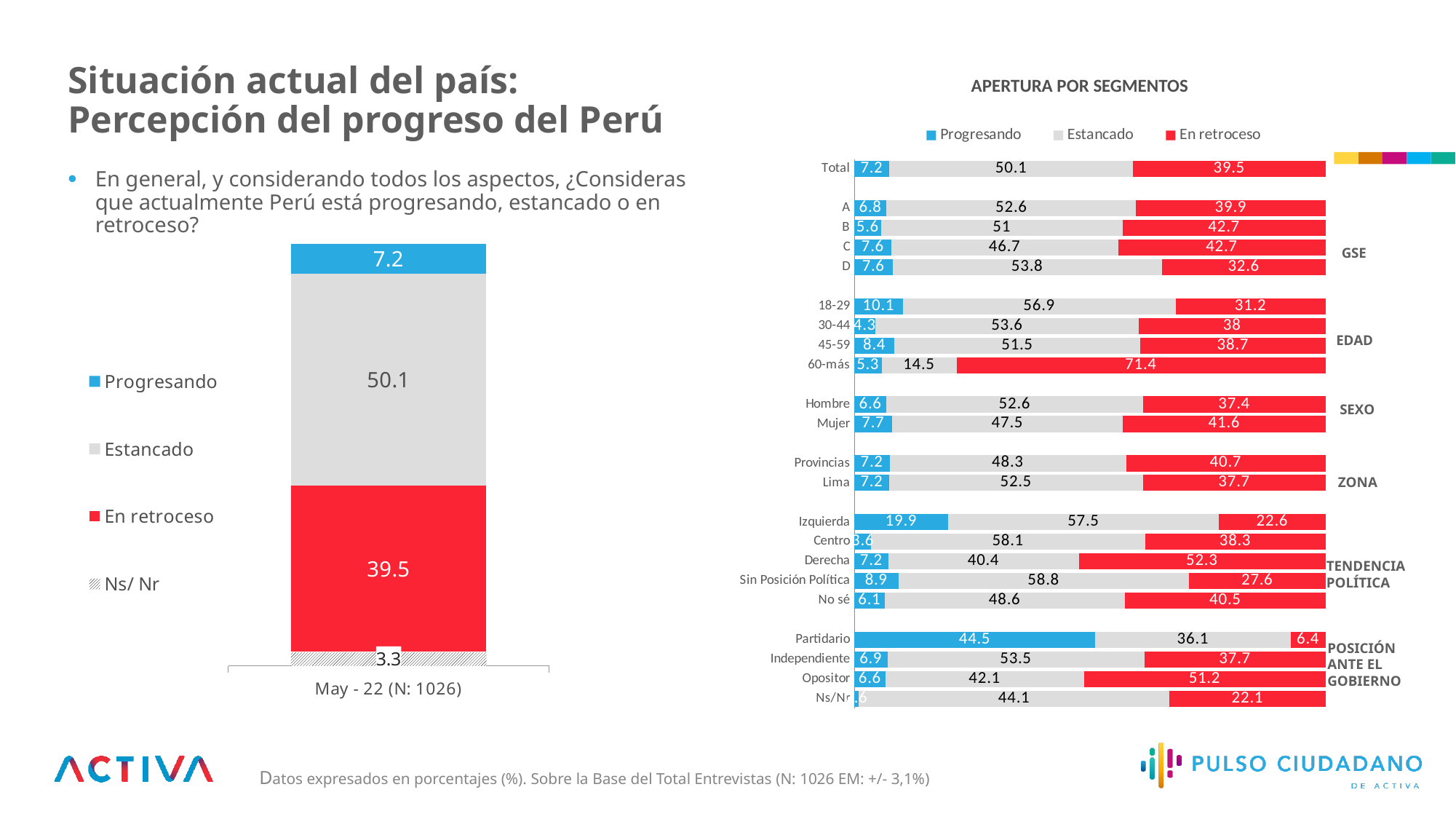
How many series does the legend of the APERTURA POR SEGMENTOS chart list? 3 In the left chart (May - 22), what is the value for Estancado? 50.1 In the left chart (May - 22), which category has the highest value? Estancado In the APERTURA POR SEGMENTOS chart, what is the difference between the En retroceso values for Derecha and Izquierda? 29.7 In the APERTURA POR SEGMENTOS chart, what is the En retroceso value for 60-más? 71.4 What kind of chart is the left chart (May - 22)? Stacked bar chart In the left chart (May - 22), what is the value for Ns/ Nr? 3.3 In the APERTURA POR SEGMENTOS chart, which has the larger En retroceso value, Hombre or Mujer? Mujer How many entries does the legend of the left chart (May - 22) list? 4 In the left chart (May - 22), what is the difference between Estancado and En retroceso? 10.6 In the APERTURA POR SEGMENTOS chart, what is the Progresando value for Partidario? 44.5 In the APERTURA POR SEGMENTOS chart, which EDAD group has the highest En retroceso value? 60-más